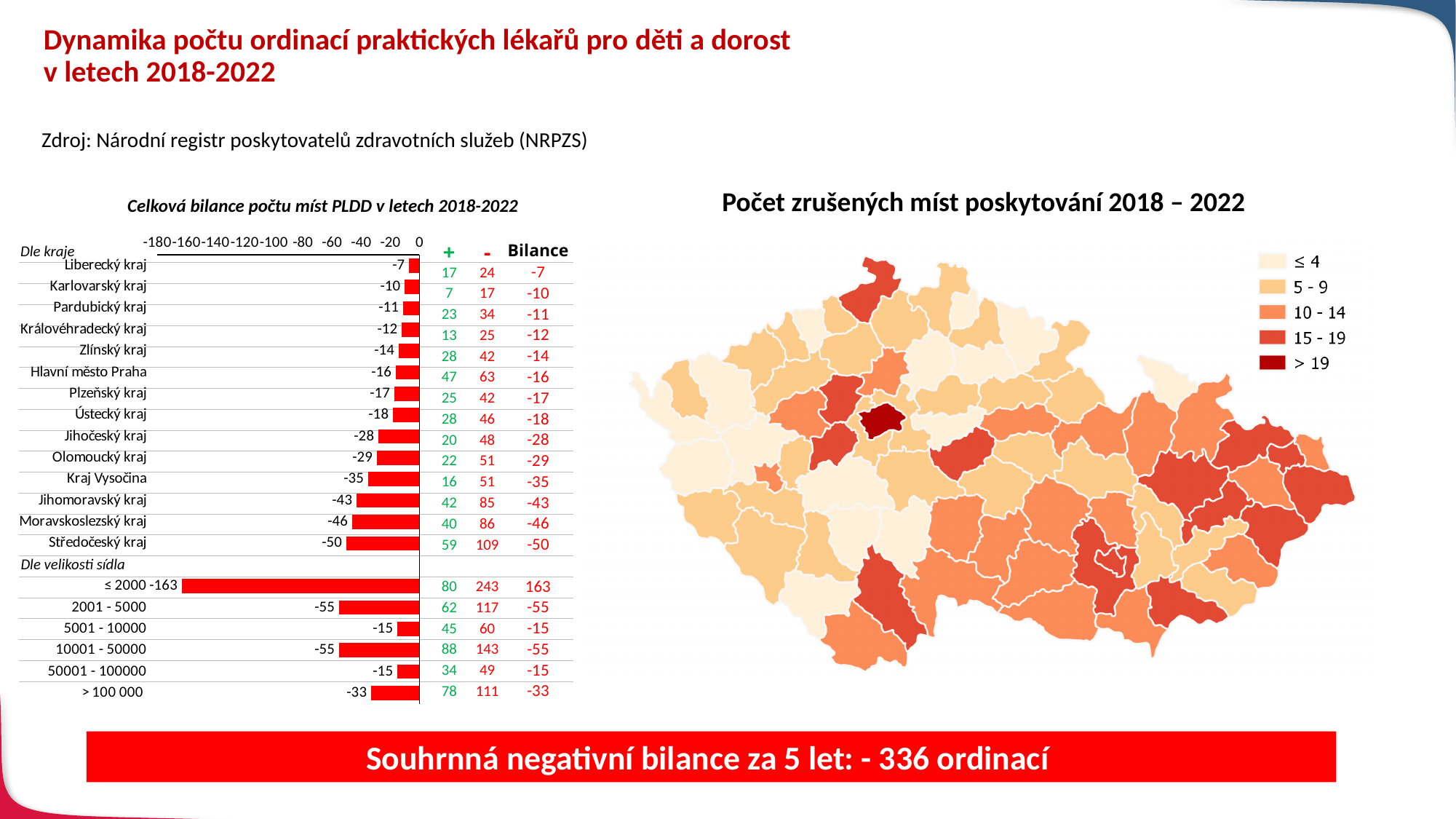
In the bar chart 'Celková bilance počtu míst PLDD v letech 2018-2022', what is the value for Středočeský kraj? -50 In the bar chart 'Celková bilance počtu míst PLDD v letech 2018-2022', which region (kraj) has the balance closest to zero? Liberecký kraj In the bar chart 'Celková bilance počtu míst PLDD v letech 2018-2022', what is the difference between the values for Moravskoslezský kraj and Jihomoravský kraj? 3 In the bar chart 'Celková bilance počtu míst PLDD v letech 2018-2022', which has the more negative balance, Kraj Vysočina or Jihomoravský kraj? Jihomoravský kraj In the bar chart 'Celková bilance počtu míst PLDD v letech 2018-2022', what is the value for the settlement size category ≤ 2000? -163 What kind of chart is 'Celková bilance počtu míst PLDD v letech 2018-2022'? bar chart In the bar chart 'Celková bilance počtu míst PLDD v letech 2018-2022', what is the difference between the values for ≤ 2000 and > 100 000? 130 In the map 'Počet zrušených míst poskytování 2018 – 2022', how many colour categories does the legend list? 5 In the bar chart 'Celková bilance počtu míst PLDD v letech 2018-2022', is the value for Středočeský kraj greater or less than -40? less In the bar chart 'Celková bilance počtu míst PLDD v letech 2018-2022', what is the value for Hlavní město Praha? -16 In the bar chart 'Celková bilance počtu míst PLDD v letech 2018-2022', how many regions (kraje) are listed in the 'Dle kraje' section? 14 In the bar chart 'Celková bilance počtu míst PLDD v letech 2018-2022', which region (kraj) has the most negative balance? Středočeský kraj